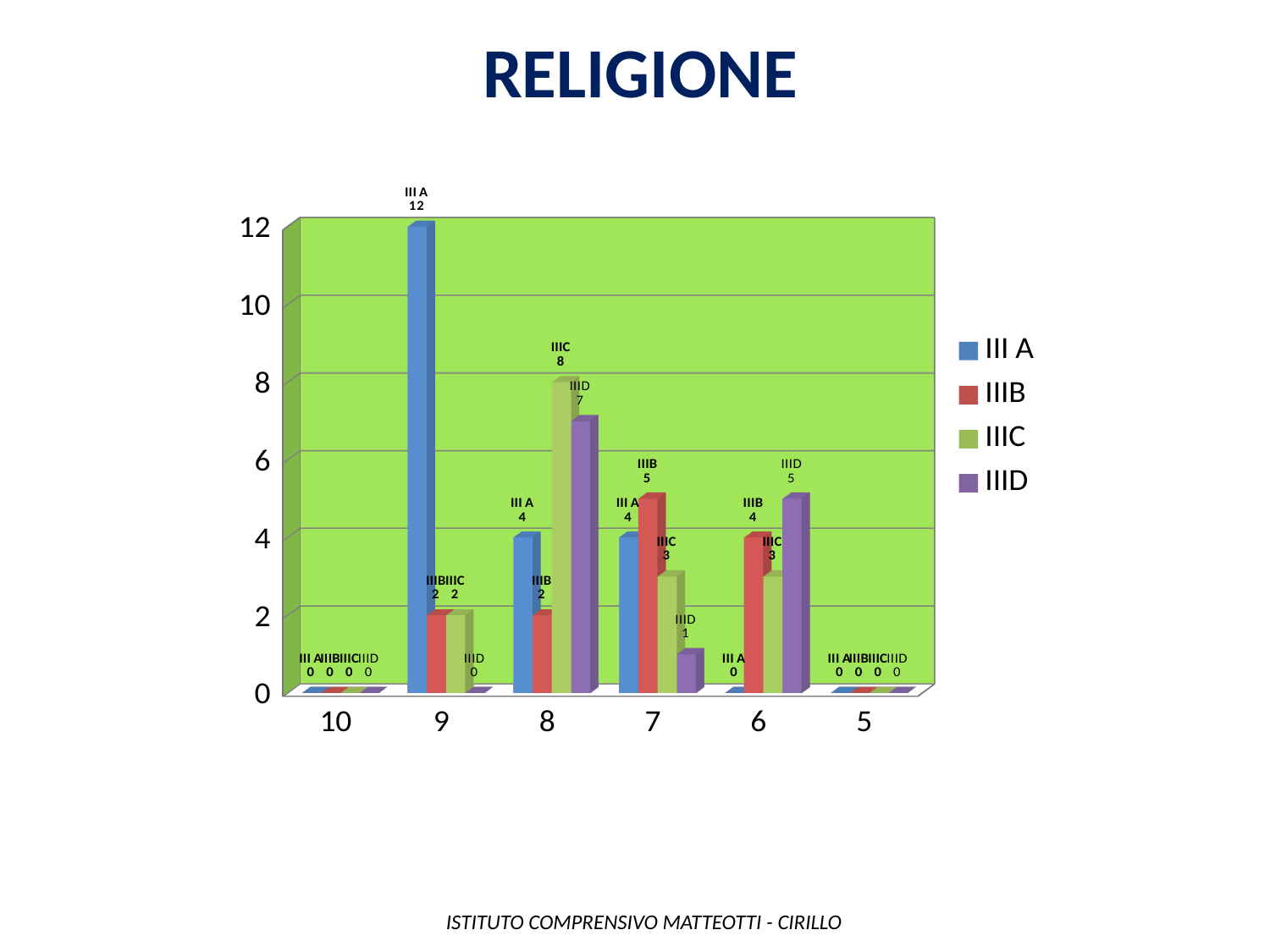
How many categories are shown on the x axis? 6 Which series has the lowest value at grade 7? IIID What is the title of the chart? RELIGIONE What is the value for IIIB at grade 6? 4 Which is larger: IIID at grade 8 or IIID at grade 6? IIID at grade 8 What type of chart is shown on the slide? bar chart What is the value for III A at grade 9? 12 What is the value for IIID at grade 7? 1 What is the difference between the III A value at grade 9 and the III A value at grade 8? 8 What is the value for IIIC at grade 8? 8 Which series has the highest value at grade 8? IIIC How many series does the legend list? 4